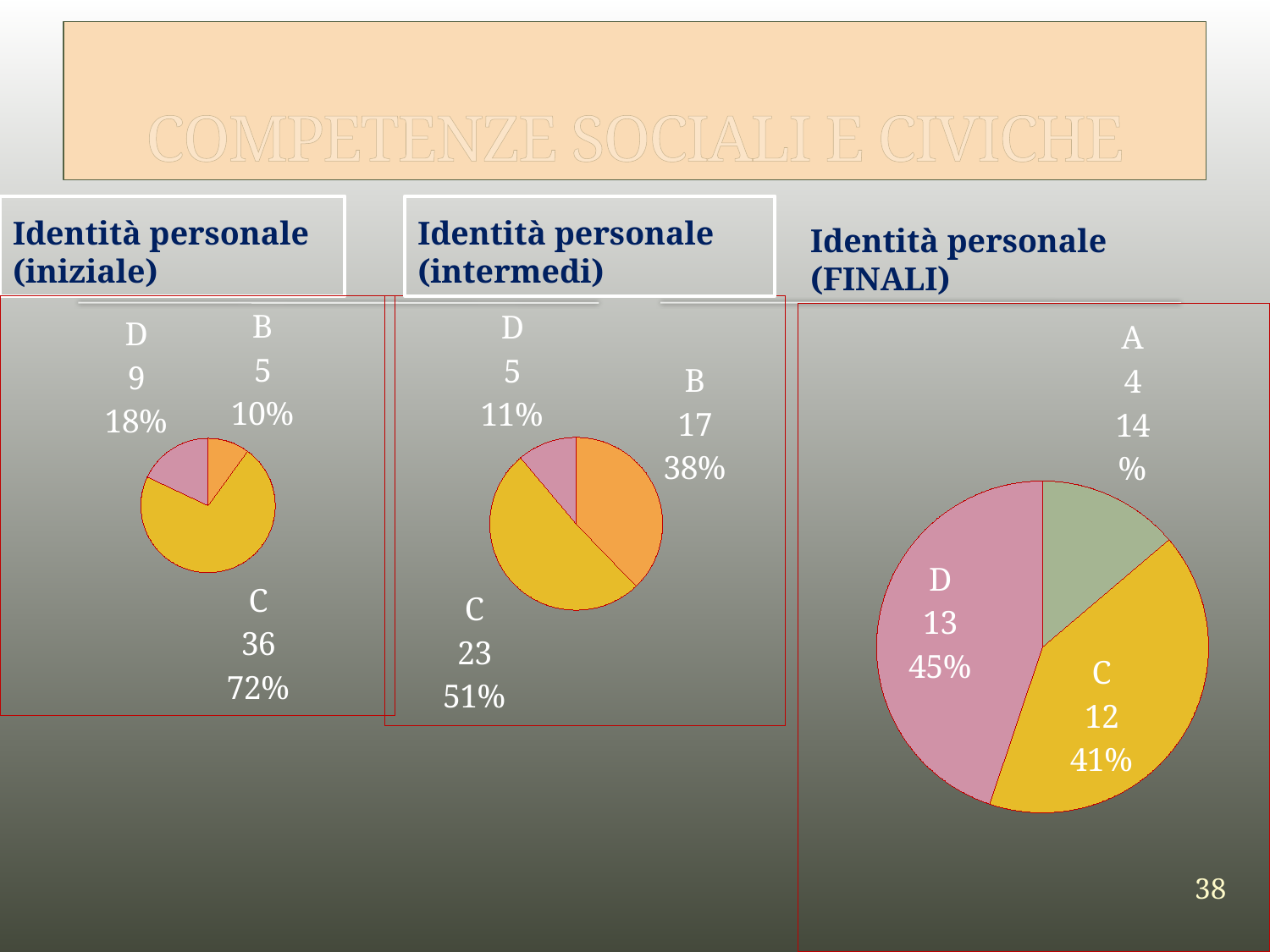
In the 'Identità personale (FINALI)' chart, which category has the largest slice? D In the 'Identità personale (iniziale)' chart, what value is shown for category C? 36 In the 'Identità personale (intermedi)' chart, what percentage share does category C have? 51% In the 'Identità personale (intermedi)' chart, what value is shown for category B? 17 In the 'Identità personale (intermedi)' chart, what is the difference between the values for C and B? 6 Which is larger in the 'Identità personale (iniziale)' chart: the value for D or the value for B? D In the 'Identità personale (iniziale)' chart, what percentage share does category D have? 18% What type of chart is used for 'Identità personale (intermedi)'? Pie chart In the 'Identità personale (FINALI)' chart, what percentage share does category A have? 14% In the 'Identità personale (FINALI)' chart, what value is shown for category D? 13 In the 'Identità personale (iniziale)' chart, which category has the smallest slice? B In the 'Identità personale (FINALI)' chart, how many categories are shown? 3